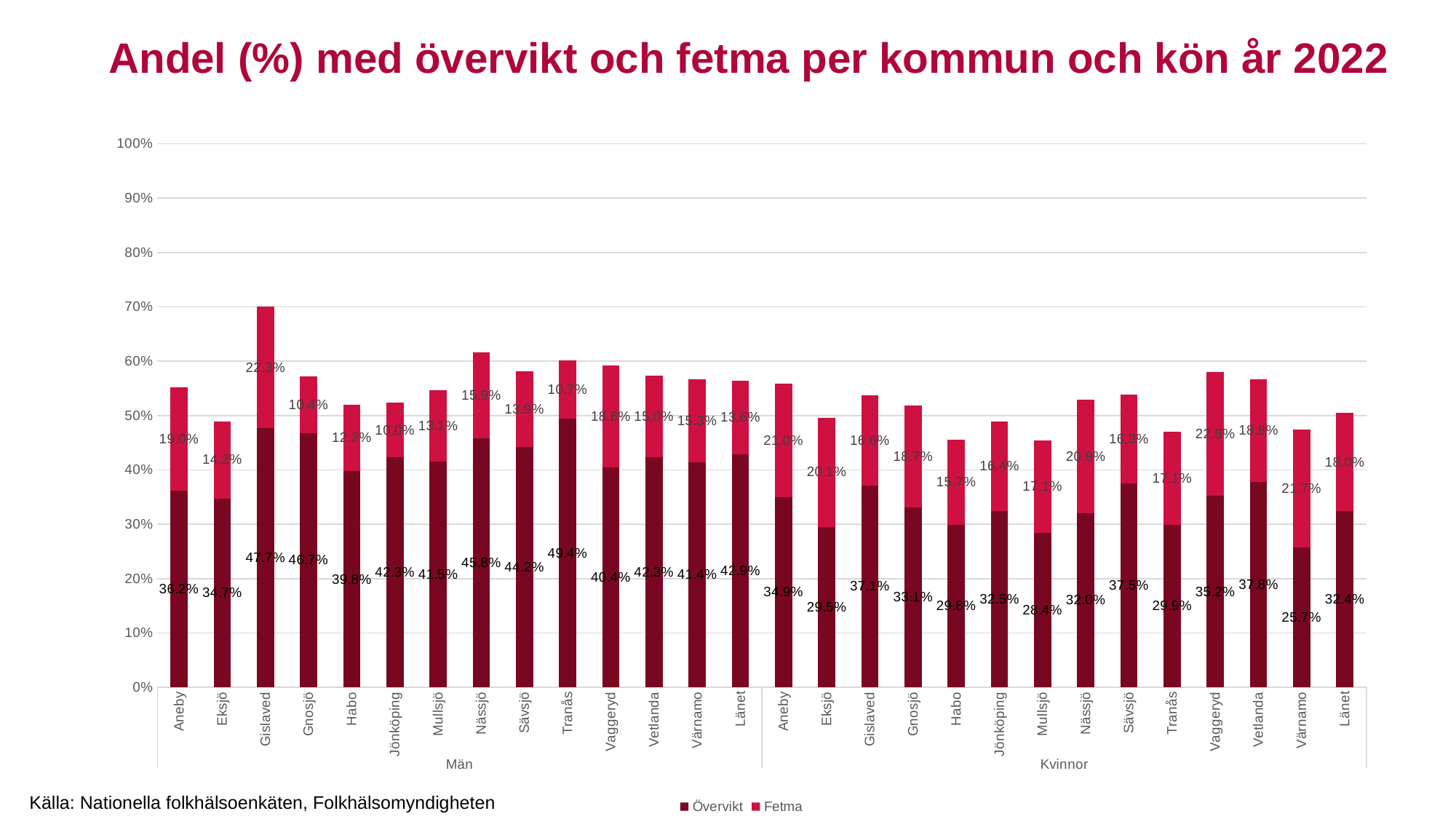
What is the Fetma value for Länet in the Män group? 13.6% Which category has the highest Fetma value in the Kvinnor group? Vaggeryd How many series does the legend list? 2 What is the difference between the Fetma values for Gislaved and Jönköping in the Män group? 12.3 percentage points Is the Övervikt value for Aneby larger in the Män group or the Kvinnor group? Män Which municipality has the highest Övervikt value in the Män group? Tranås What kind of chart is shown on the slide? Stacked bar chart How many categories are shown in the Kvinnor group? 14 What is the total of the stacked bar for Gislaved in the Män group? 70.0% What is the Fetma value for Värnamo in the Kvinnor group? 21.7% What is the Övervikt value for Gislaved in the Män group? 47.7% Which municipality has the lowest Övervikt value in the Kvinnor group? Värnamo